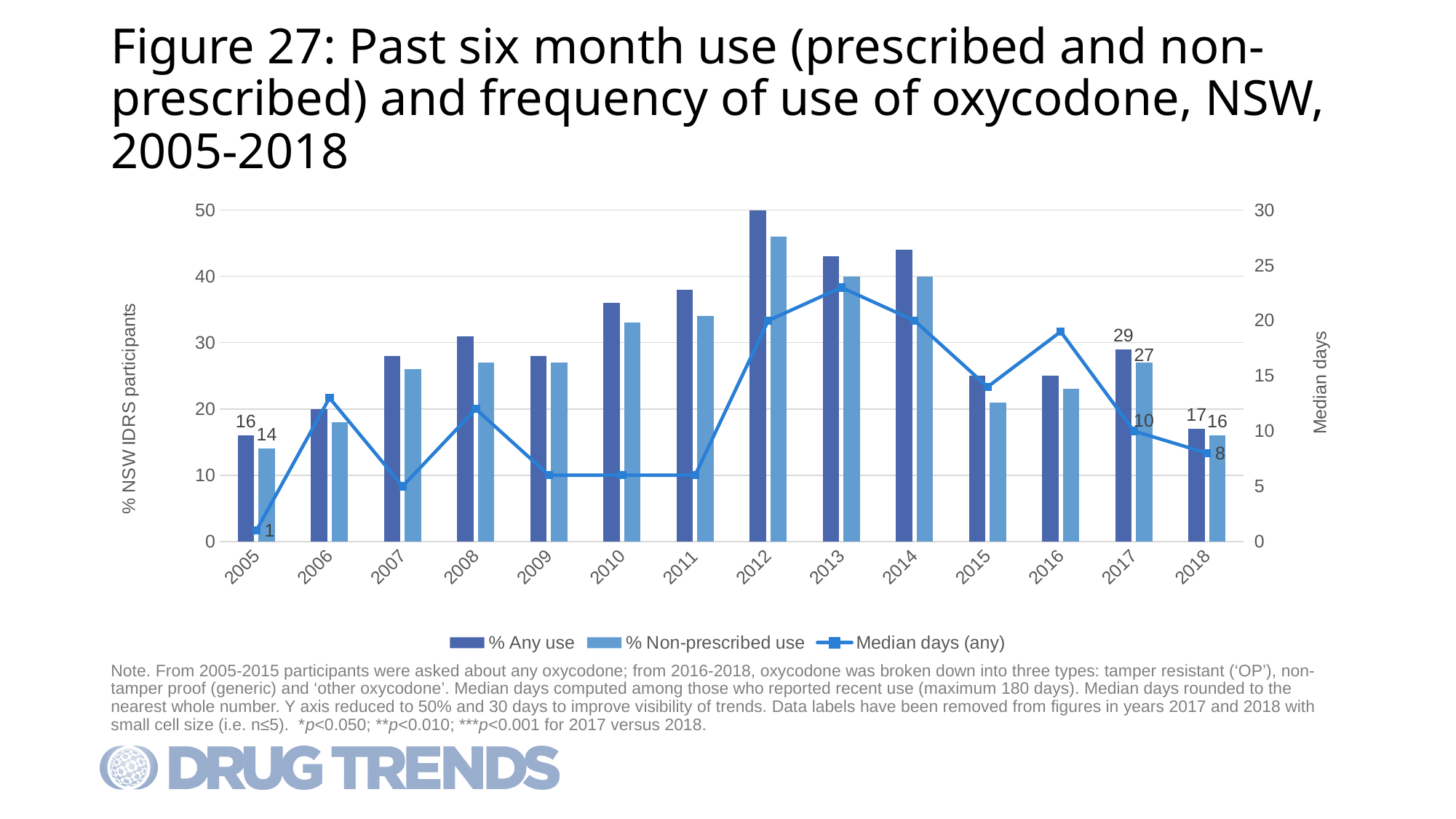
In 2005, how much higher is % Any use than % Non-prescribed use? 2 What is the difference between % Any use in 2017 and % Any use in 2018? 12 What is the value of % Any use in 2005? 16 What is the Median days (any) value in 2018? 8 Is the value for % Non-prescribed use in 2015 greater or less than 30? less What is the value of % Non-prescribed use in 2017? 27 Which year has the larger % Any use, 2009 or 2010? 2010 Which year has the highest % Any use? 2012 Is the value for % Any use in 2012 greater or less than 40? greater Which year has the lowest Median days (any)? 2005 How many series does the legend list? 3 How many years are shown on the x axis? 14